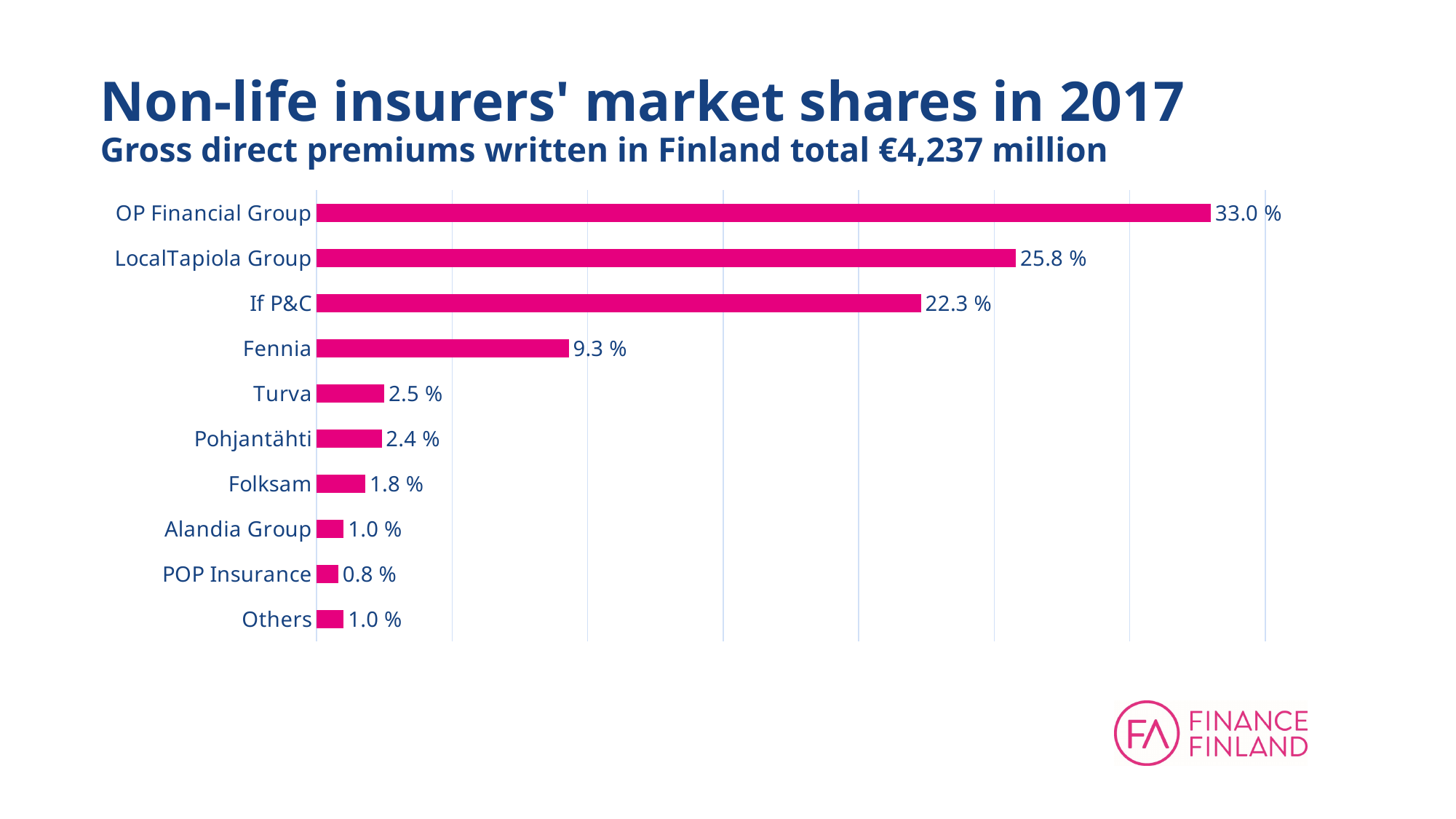
What is the market share of Fennia? 9.3 % Which insurer has the smallest market share? POP Insurance What type of chart is shown on the slide? Bar chart What is the difference in market share between OP Financial Group and LocalTapiola Group? 7.2 % Which has a larger market share, Turva or Folksam? Turva Which has a larger market share, LocalTapiola Group or If P&C? LocalTapiola Group Which insurer has the largest market share? OP Financial Group What is the market share of POP Insurance? 0.8 % What is the title of the chart? Non-life insurers' market shares in 2017 What is the difference in market share between If P&C and Fennia? 13.0 % How many categories are shown in the chart? 10 What is the market share of OP Financial Group? 33.0 %